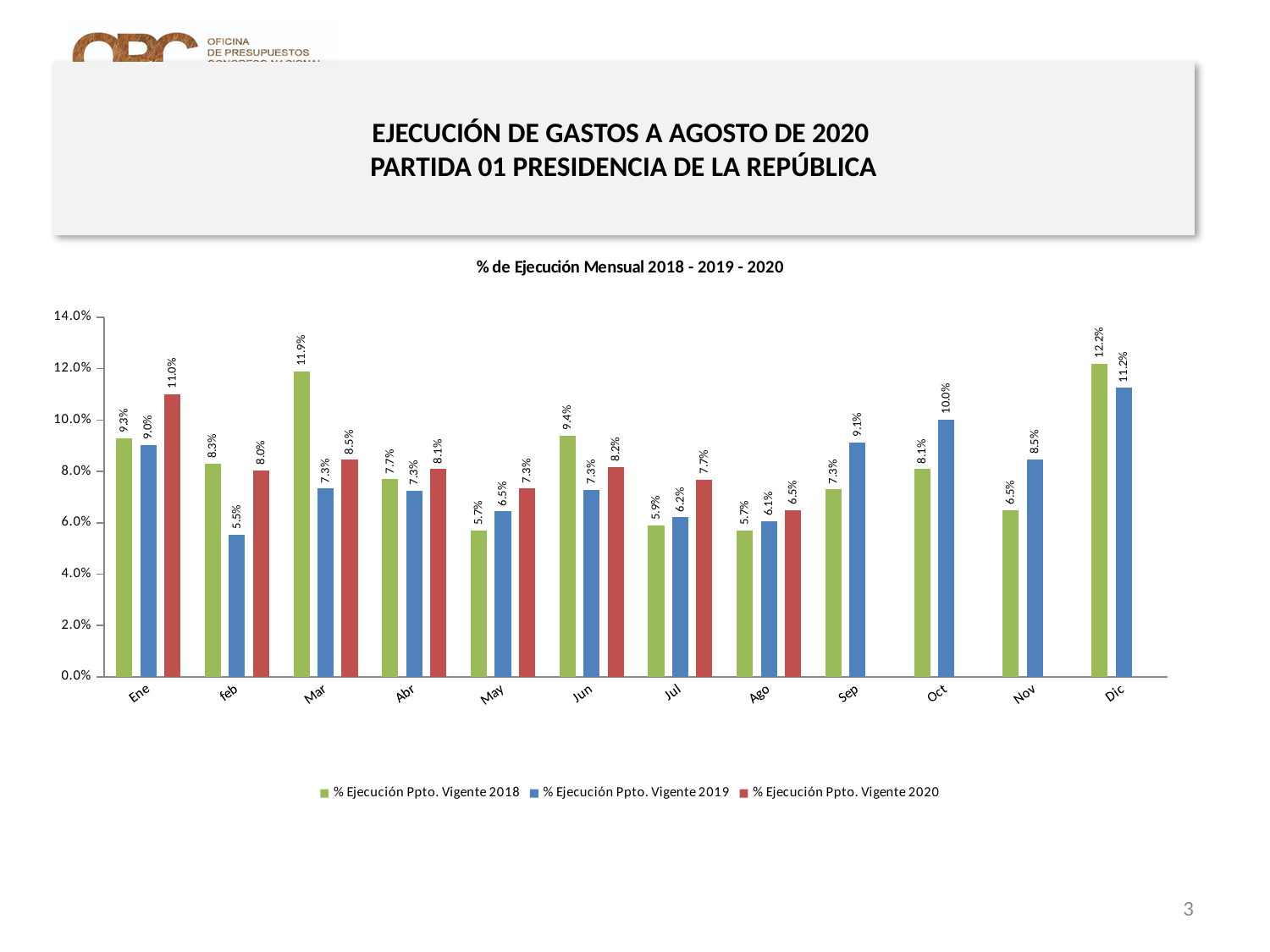
What is the value for % Ejecución Ppto. Vigente 2018 in Mar? 11.9% In which month is the % Ejecución Ppto. Vigente 2018 series highest? Dic How many series does the legend list? 3 In which month is the % Ejecución Ppto. Vigente 2019 series lowest? feb What is the value for % Ejecución Ppto. Vigente 2020 in Ene? 11.0% What is the value for % Ejecución Ppto. Vigente 2019 in feb? 5.5% What is the difference between the 2018 and 2019 values in Mar? 4.6% How many months are shown on the x axis? 12 Which is larger in Sep: the 2018 value or the 2019 value? 2019 In which month is the % Ejecución Ppto. Vigente 2020 series lowest? Ago What is the value for % Ejecución Ppto. Vigente 2019 in Oct? 10.0% What kind of chart is shown on the slide? Bar chart